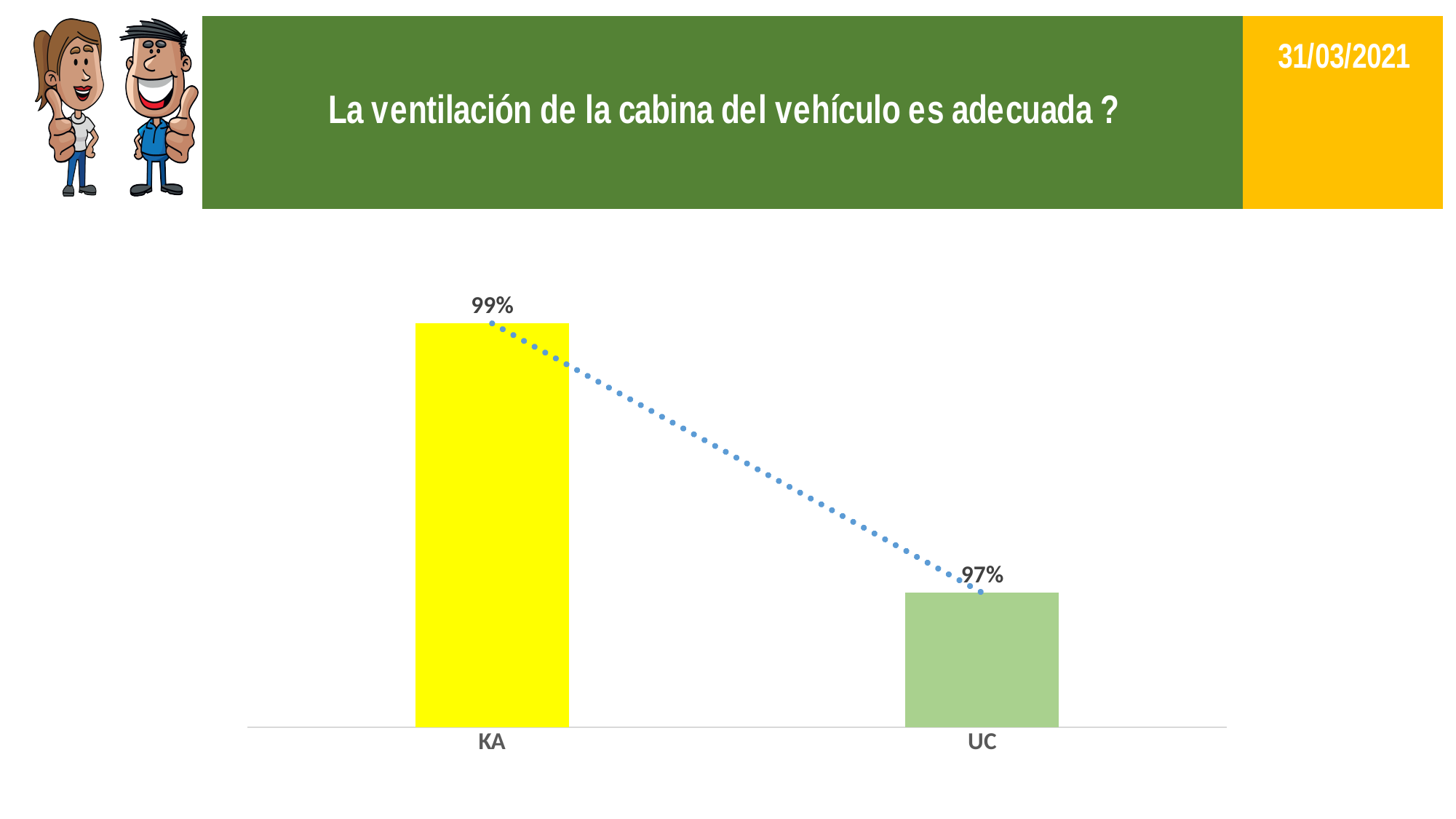
Which category has the highest value? KA What is the value for UC? 97% What is the difference between the values for KA and UC? 2% What kind of chart is shown on the slide? Bar chart Which category has the lowest value? UC What colour is the bar for KA? Yellow Which is larger, the value for KA or the value for UC? KA How many categories are shown on the x axis? 2 What colour is the bar for UC? Light green Do the values rise or fall from KA to UC? Fall What is the value for KA? 99%